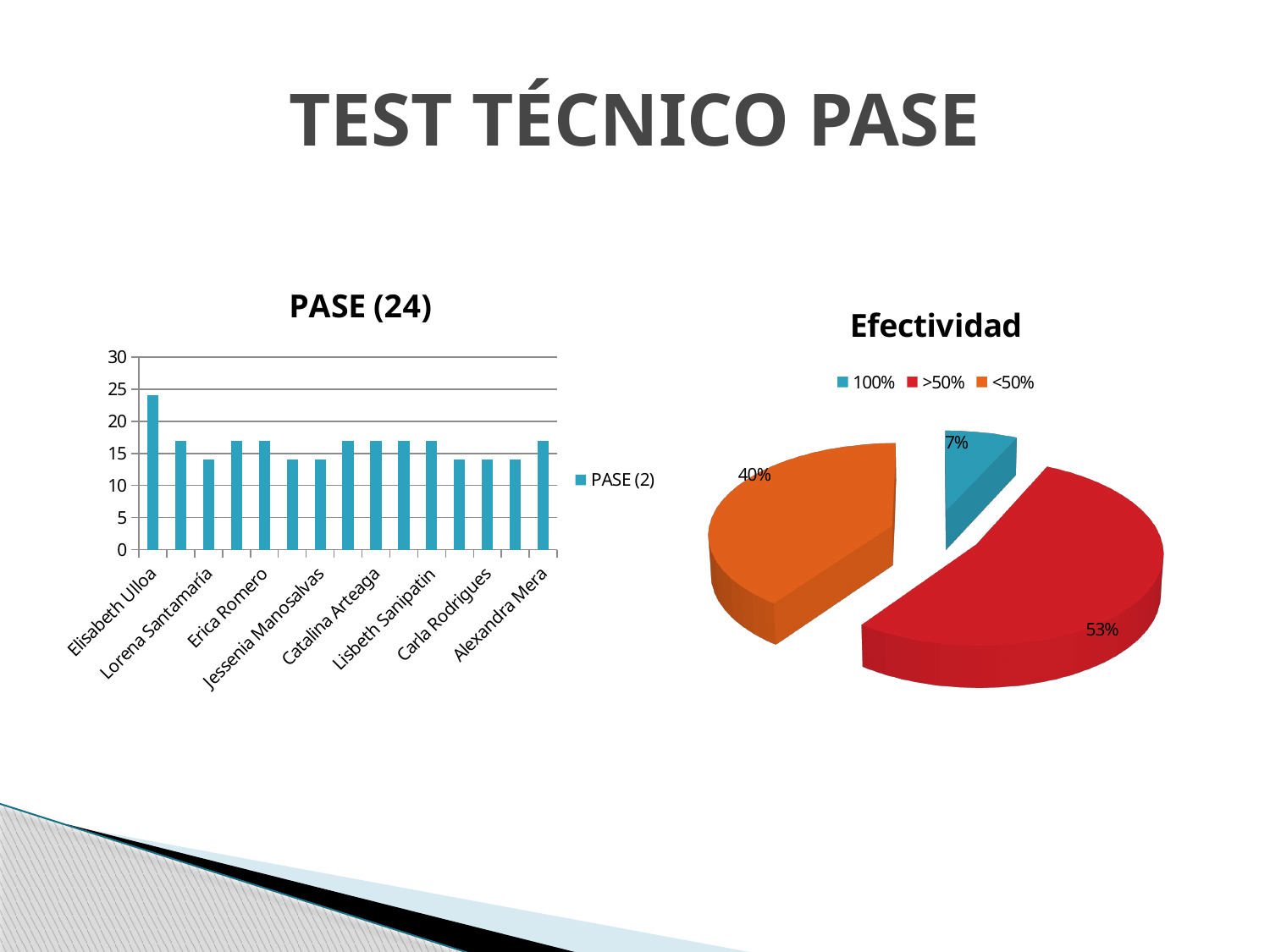
In the PASE (24) chart, is the value for Elisabeth Ulloa greater or less than 20? greater What kind of chart is the Efectividad chart? Pie chart In the Efectividad pie chart, which category has the smallest slice? 100% In the Efectividad pie chart, which category has the largest slice? >50% In the Efectividad pie chart, what share does the <50% slice have? 40% In the Efectividad pie chart, how many percentage points larger is the >50% slice than the <50% slice? 13 In the Efectividad pie chart, what share does the 100% slice have? 7% In the Efectividad chart, how many entries does the legend list? 3 In the PASE (24) chart, which person has the highest bar? Elisabeth Ulloa In the Efectividad pie chart, what share does the >50% slice have? 53% What kind of chart is the PASE (24) chart? Bar chart In the PASE (24) chart, is the value for Erica Romero greater or less than 15? greater